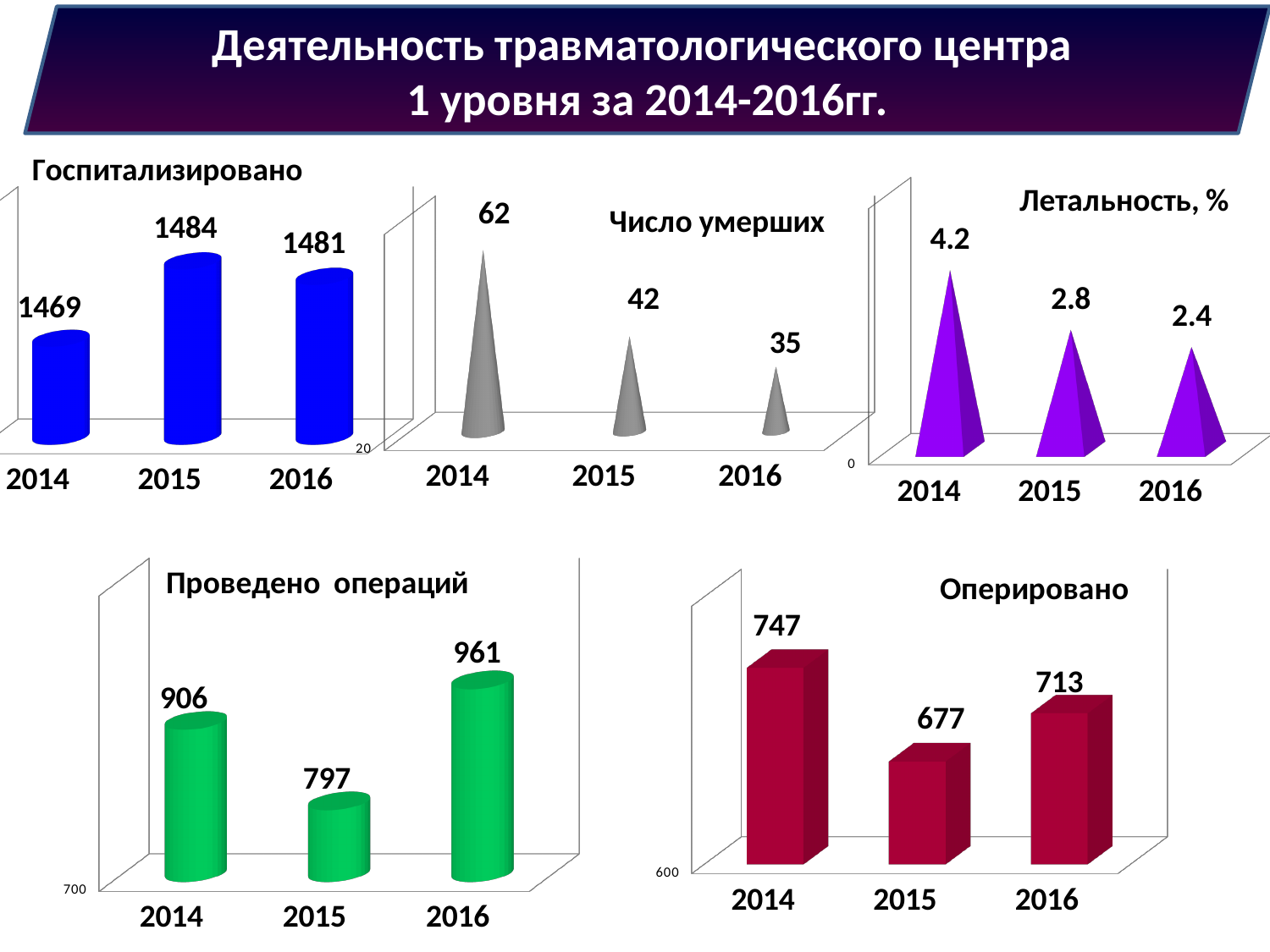
In the 'Число умерших' chart, what is the difference between the 2014 and 2016 values? 27 In the 'Число умерших' chart, what is the value for 2014? 62 In the 'Летальность, %' chart, which year has the highest value? 2014 In the 'Оперировано' chart, what is the difference between the 2014 and 2015 values? 70 In the 'Летальность, %' chart, what is the value for 2016? 2.4 In the 'Госпитализировано' chart, which year has the lowest value? 2014 In the 'Число умерших' chart, do the values rise or fall from 2014 to 2016? fall In the 'Проведено операций' chart, what is the value for 2015? 797 How many charts are shown on the slide? 5 In the 'Госпитализировано' chart, what is the value for 2015? 1484 In the 'Проведено операций' chart, which year has the highest value? 2016 In the 'Оперировано' chart, which is larger, the value for 2014 or the value for 2016? 2014